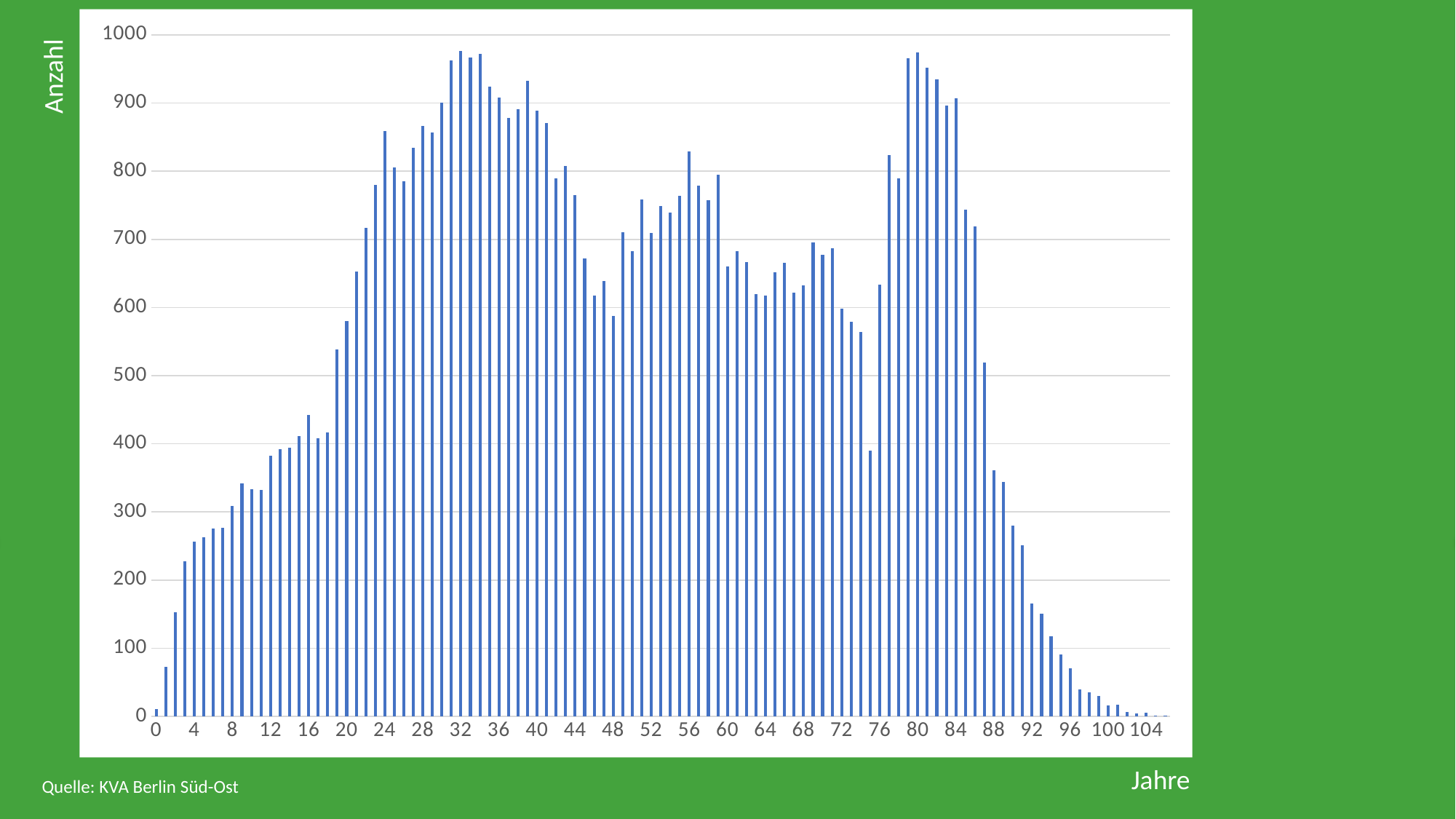
Is the value for 88 Jahre greater or less than 400? less Is the value for 24 Jahre greater or less than 800? greater Is the value for 4 Jahre greater or less than 300? less Do the values rise or fall along the x axis from 88 to 104 Jahre? fall What kind of chart is shown on the slide? bar chart What is the label of the vertical axis? Anzahl What is the label of the horizontal axis? Jahre Do the values rise or fall along the x axis from 0 to 32 Jahre? rise Which is larger, the value for 76 Jahre or the value for 96 Jahre? 76 Jahre